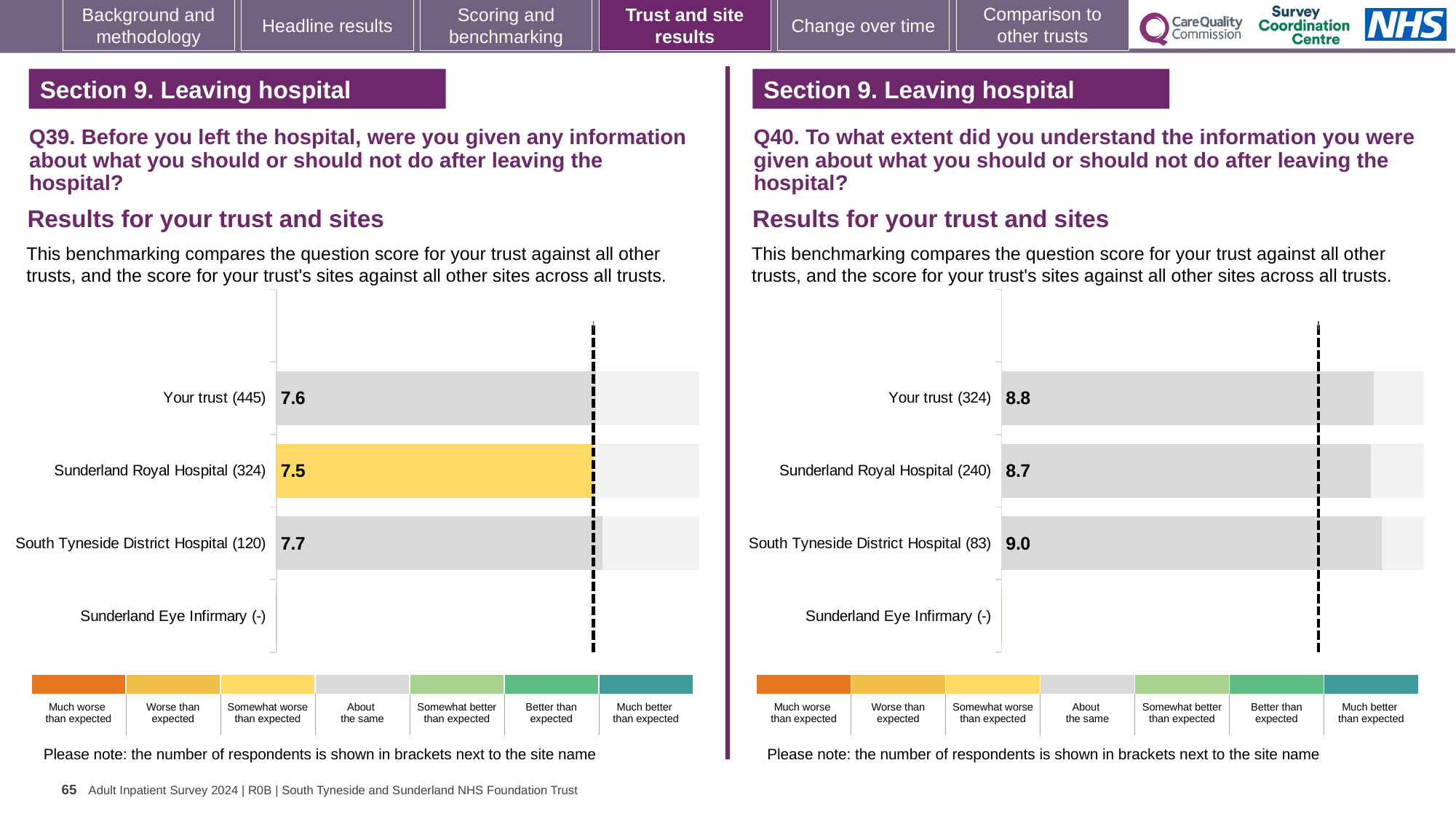
On the Q40 chart (right), which site has the lowest score? Sunderland Royal Hospital On the Q39 chart (left), which site's bar is coloured yellow? Sunderland Royal Hospital What type of chart is used on the Q39 chart (left)? Bar chart On the Q40 chart (right), what is the score for Your trust? 8.8 On the Q39 chart (left), which has the higher score: Your trust or Sunderland Royal Hospital? Your trust On the Q40 chart (right), what is the difference between the scores for South Tyneside District Hospital and Sunderland Royal Hospital? 0.3 On the Q40 chart (right), what is the score for South Tyneside District Hospital? 9.0 On the Q39 chart (left), how many respondents are shown in brackets for Sunderland Royal Hospital? 324 On the Q39 chart (left), what is the score for Sunderland Royal Hospital? 7.5 How many rows (sites including Your trust) are listed on the Q40 chart (right)? 4 On the Q39 chart (left), which site has the highest score? South Tyneside District Hospital On the Q39 chart (left), what is the score for Your trust? 7.6